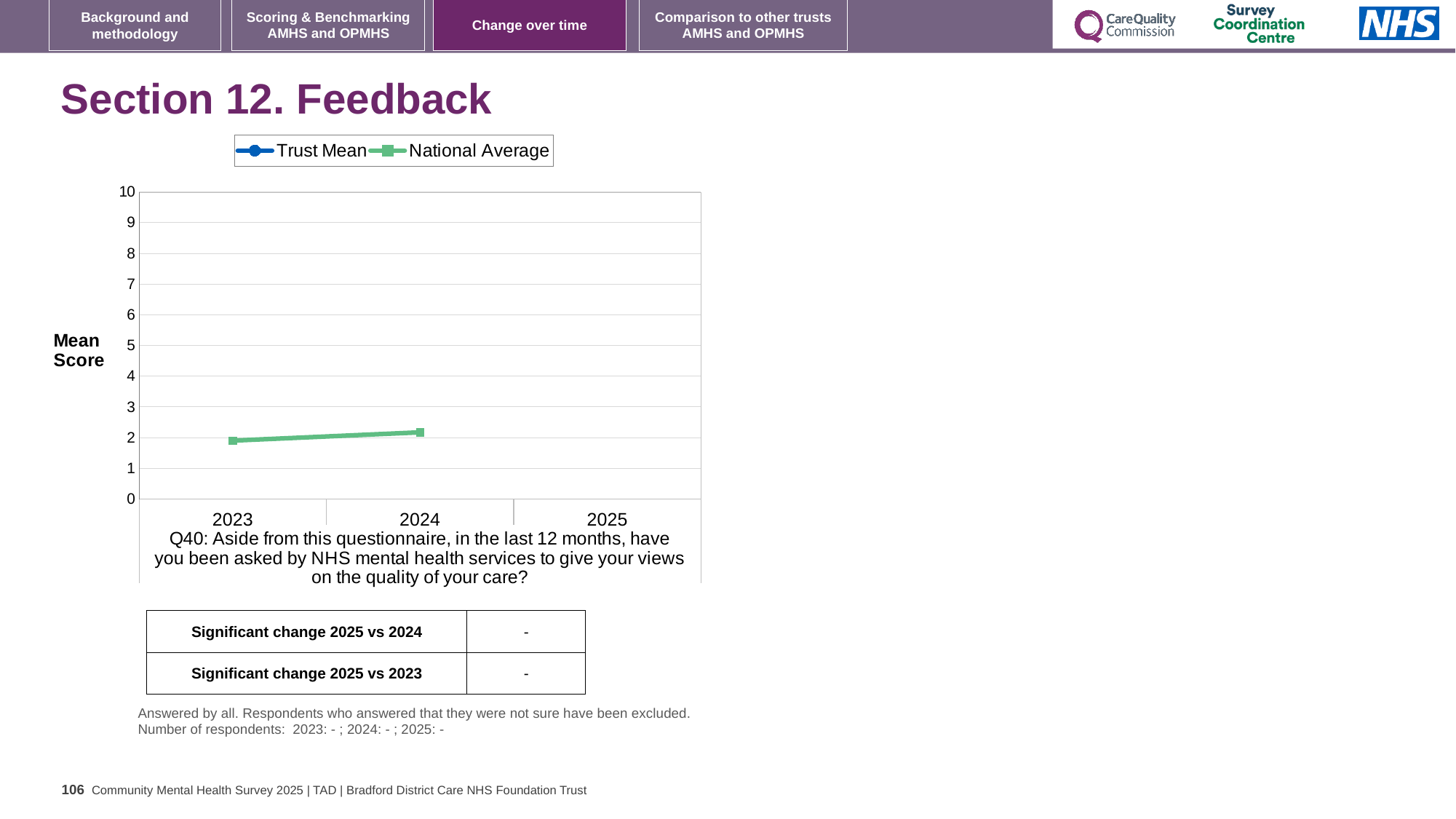
Is the National Average value for 2023 greater or less than 3? less What kind of chart is shown on the slide? line chart Which year has the higher National Average value, 2023 or 2024? 2024 Does the National Average line rise or fall from 2023 to 2024? rise What is the highest value shown on the y axis? 10 Is the National Average value for 2023 greater or less than 1? greater How many years are shown on the x axis? 3 Which year on the x axis has no National Average point plotted? 2025 Which two series are listed in the legend? Trust Mean and National Average What is the label on the y axis? Mean Score Is the National Average value for 2024 greater or less than 3? less How many series does the legend list? 2